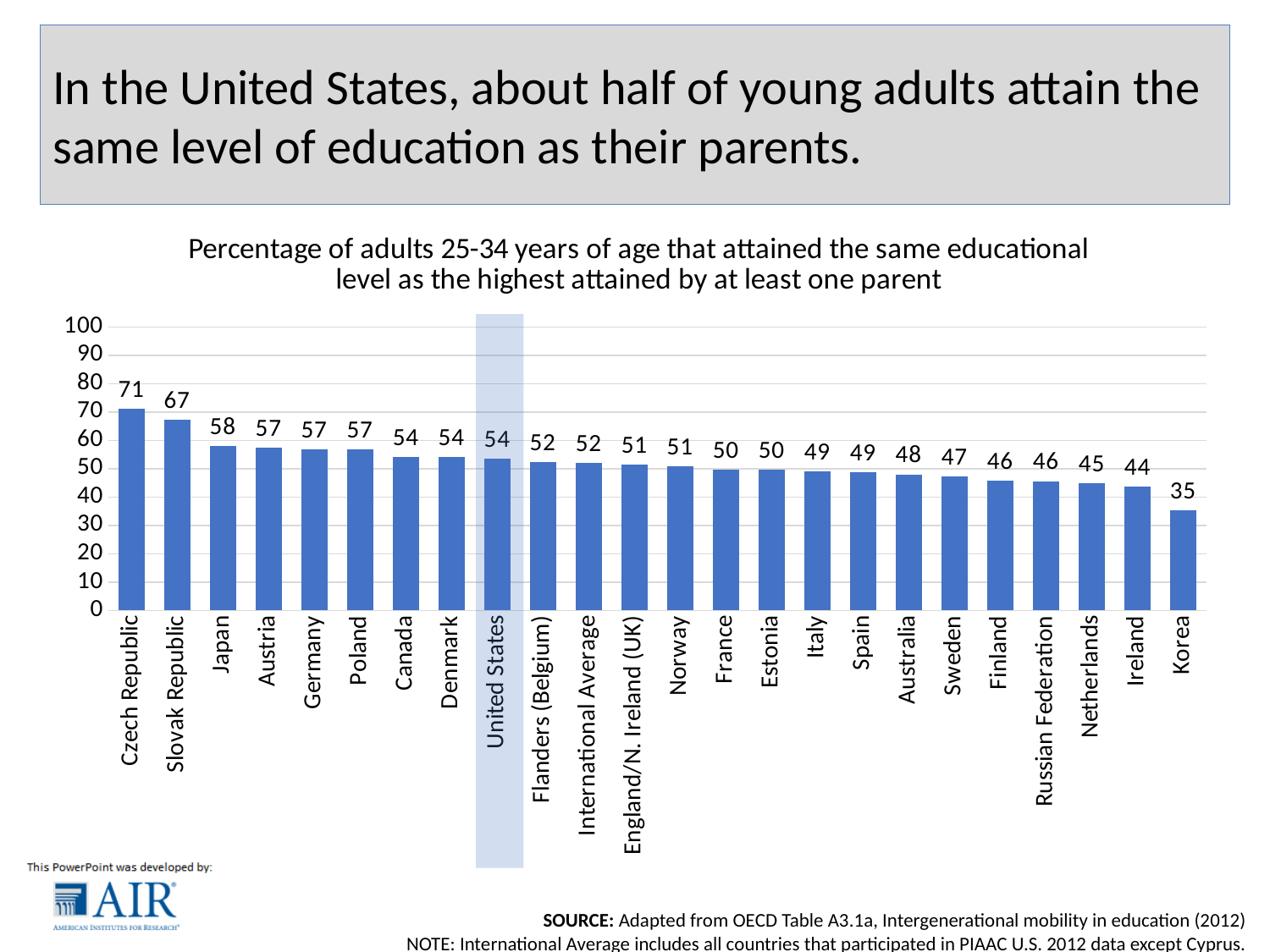
What is the difference between the values for the United States and the International Average? 2 Which country has the lowest value? Korea What is the value for the United States? 54 Is the value for the Slovak Republic greater or less than 60? greater What is the value for Korea? 35 What kind of chart is shown on the slide? Bar chart Do the values rise or fall moving from left to right along the x axis? Fall Which has a larger value, Japan or Sweden? Japan Which country has the highest value? Czech Republic What is the difference between the values for the Czech Republic and Korea? 36 What is the value for the International Average? 52 How many countries or categories are shown on the x axis? 24